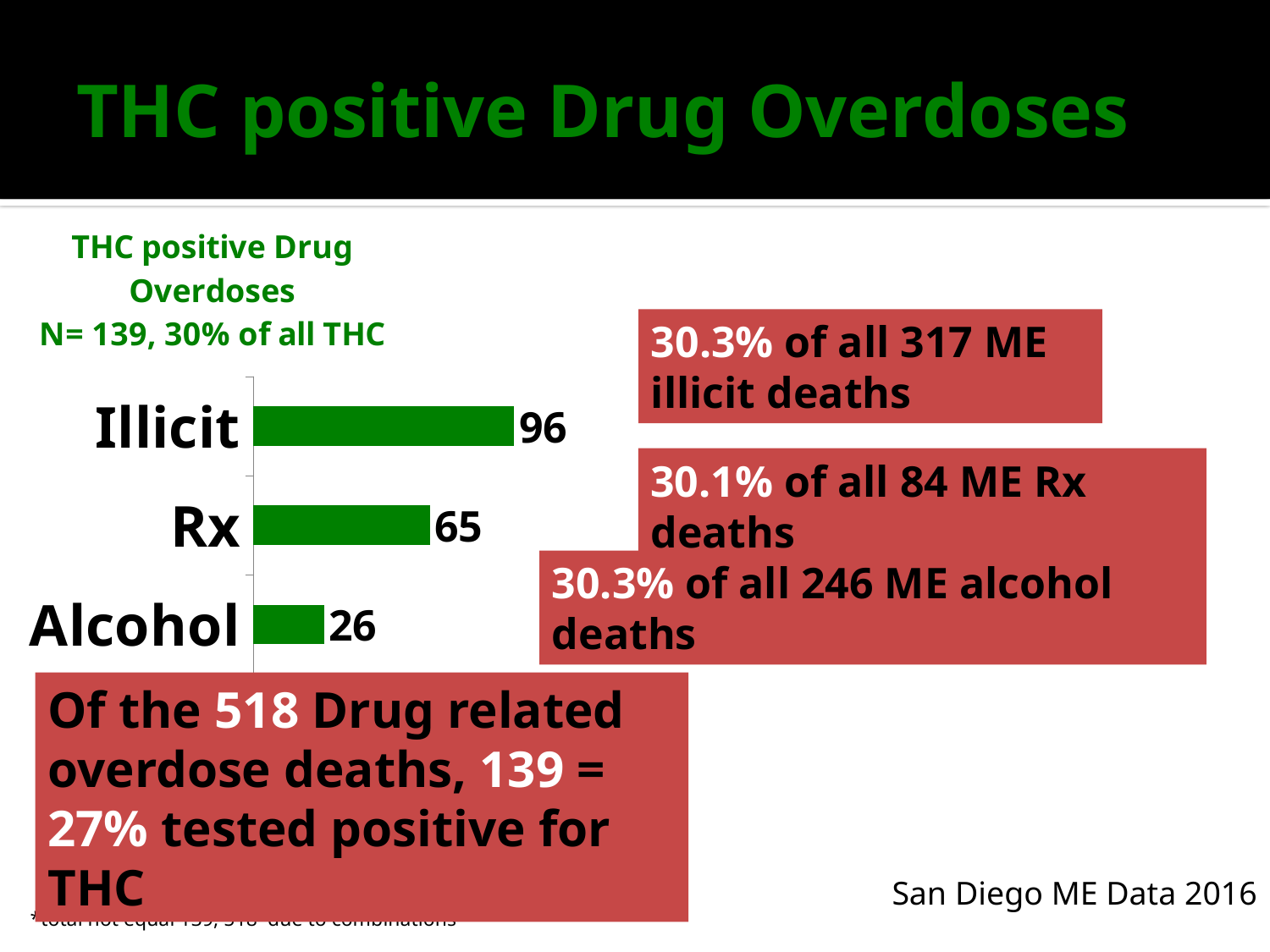
What is the value for Alcohol? 26 Which category has the lowest value? Alcohol Which category has the highest value? Illicit What is the difference between the values for Rx and Alcohol? 39 What is the value for Illicit? 96 What colour are the bars in the chart? Green How many categories are shown in the chart? 3 What is the difference between the values for Illicit and Rx? 31 What is the value for Rx? 65 Which is larger, the value for Rx or the value for Alcohol? Rx What kind of chart is shown on the slide? Bar chart What is the title of the chart? THC positive Drug Overdoses N= 139, 30% of all THC